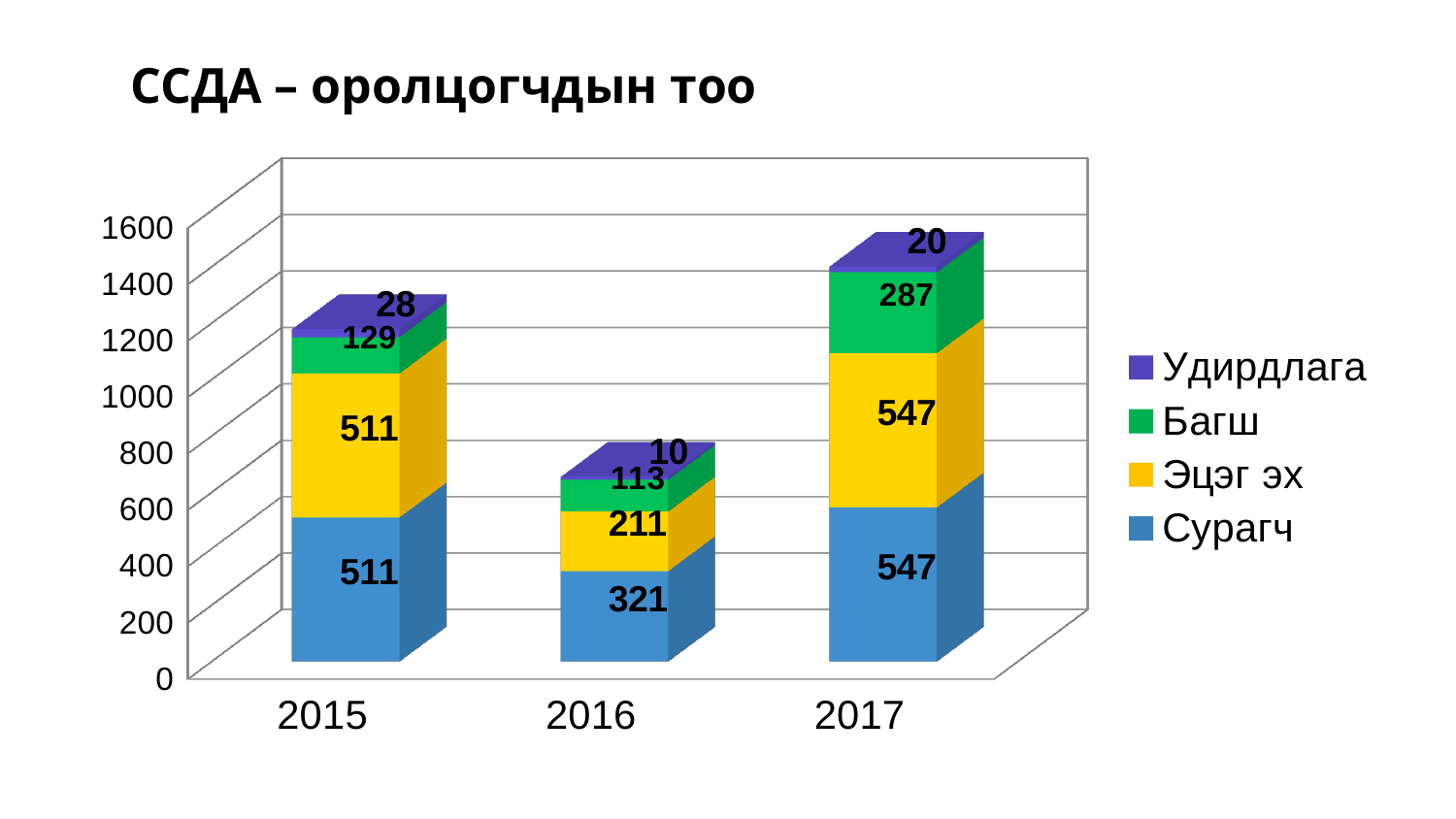
Which year has the highest value for Багш? 2017 Which is larger, the Удирдлага value for 2015 or for 2017? 2015 How many series does the legend list? 4 What is the value for Сурагч in 2016? 321 What kind of chart is shown on the slide? Stacked bar chart What is the total of the stacked bar for 2016? 655 Which year has the lowest value for Сурагч? 2016 What is the value for Удирдлага in 2015? 28 What is the value for Эцэг эх in 2016? 211 What is the difference between the Эцэг эх values for 2017 and 2015? 36 How many years are shown on the x axis? 3 What is the value for Багш in 2017? 287